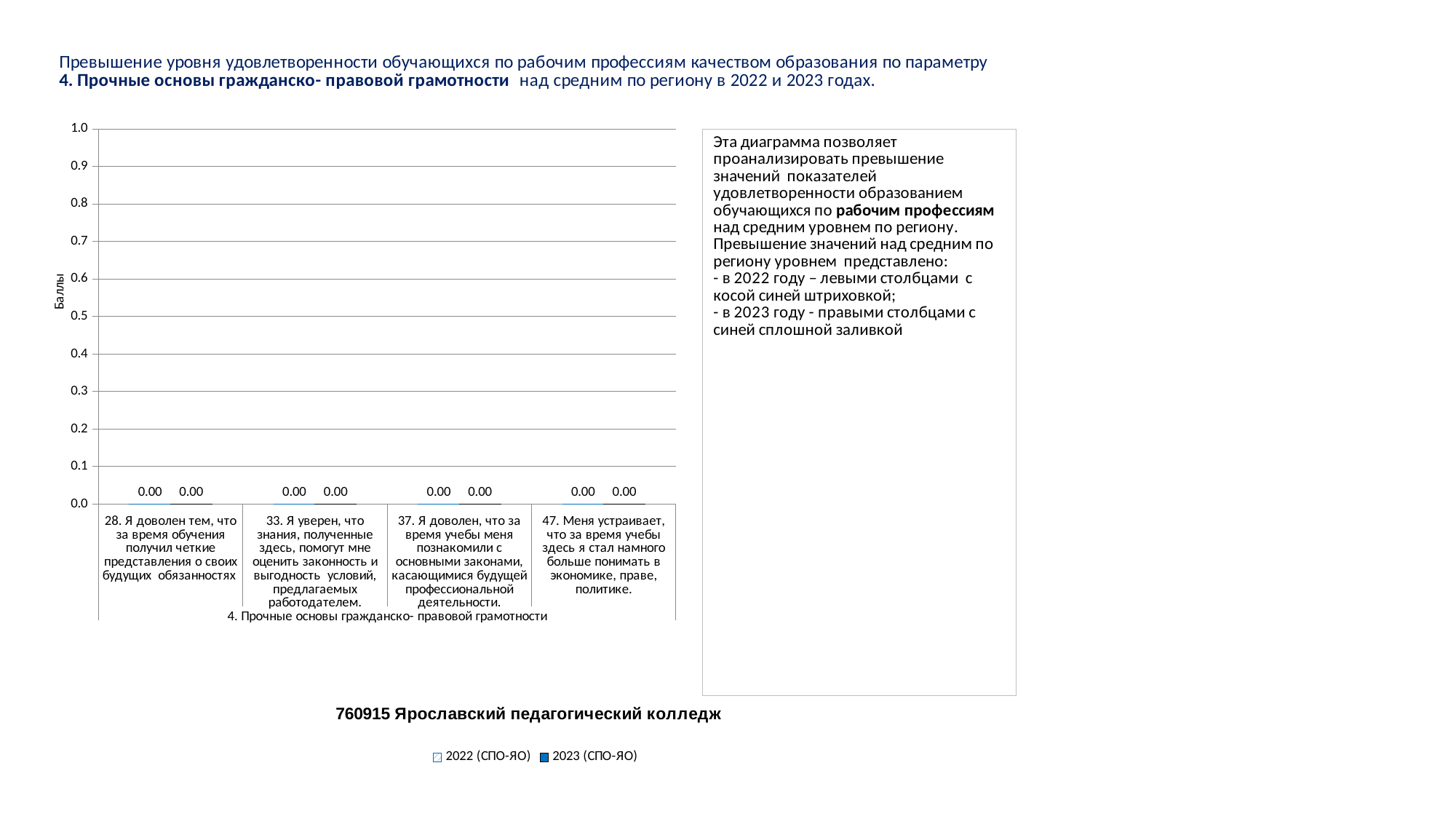
Is the 2023 (СПО-ЯО) value for category 28 greater or less than 0.5? less What kind of chart is shown on the slide? bar chart How many series does the chart legend list? 2 What is the value of the 2022 (СПО-ЯО) series for category 28 ("Я доволен тем, что за время обучения получил четкие представления о своих будущих обязанностях")? 0.00 What is the value of the 2022 (СПО-ЯО) series for category 37 ("Я доволен, что за время учебы меня познакомили с основными законами...")? 0.00 How many categories (questions) are shown along the x axis of the chart? 4 What is the difference between the 2022 (СПО-ЯО) and 2023 (СПО-ЯО) values for category 33 ("Я уверен, что знания, полученные здесь, помогут мне оценить законность и выгодность условий, предлагаемых работодателем")? 0.00 Do the values of the 2022 (СПО-ЯО) series rise, fall, or stay the same across the categories on the x axis? stay the same What is the highest tick value shown on the vertical axis of the chart? 1.0 What is the label of the vertical axis of the chart? Баллы What are the two series names listed in the chart legend? 2022 (СПО-ЯО) and 2023 (СПО-ЯО) What is the value of the 2023 (СПО-ЯО) series for category 47 ("Меня устраивает, что за время учебы здесь я стал намного больше понимать в экономике, праве, политике")? 0.00